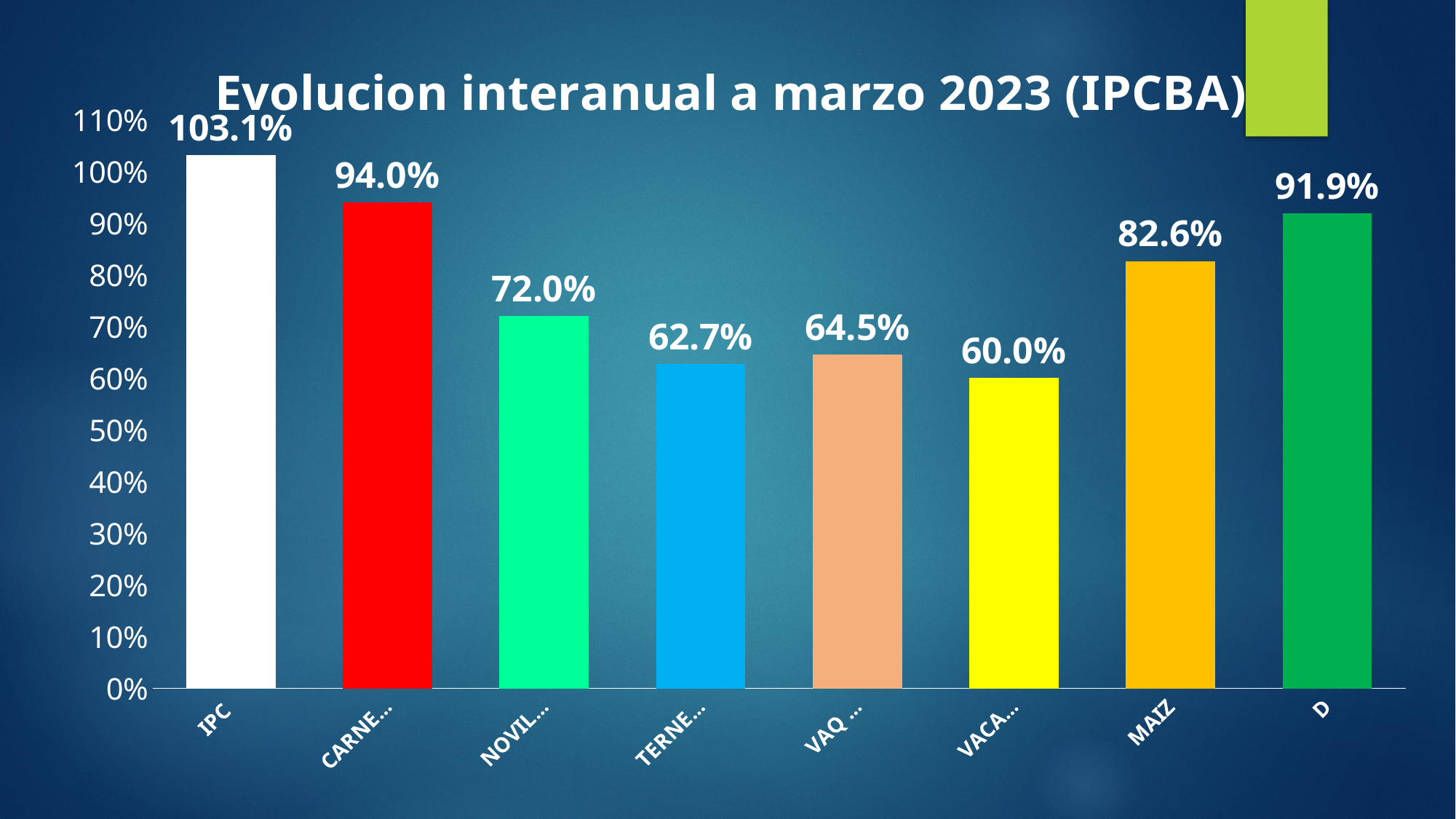
What kind of chart is shown on the slide? bar chart How many categories are shown in the chart? 8 What is the difference between the values for IPC and MAIZ? 20.5% Is the value for MAIZ greater or less than 80%? greater What is the value for the category labelled D? 91.9% What is the title of the chart? Evolucion interanual a marzo 2023 (IPCBA) What is the value for MAIZ? 82.6% What is the difference between the values for D and MAIZ? 9.3% Which is larger, the value for MAIZ or the value for D? D What is the value for IPC? 103.1% Which category has the highest value? IPC Which category has the lowest value? VACA…